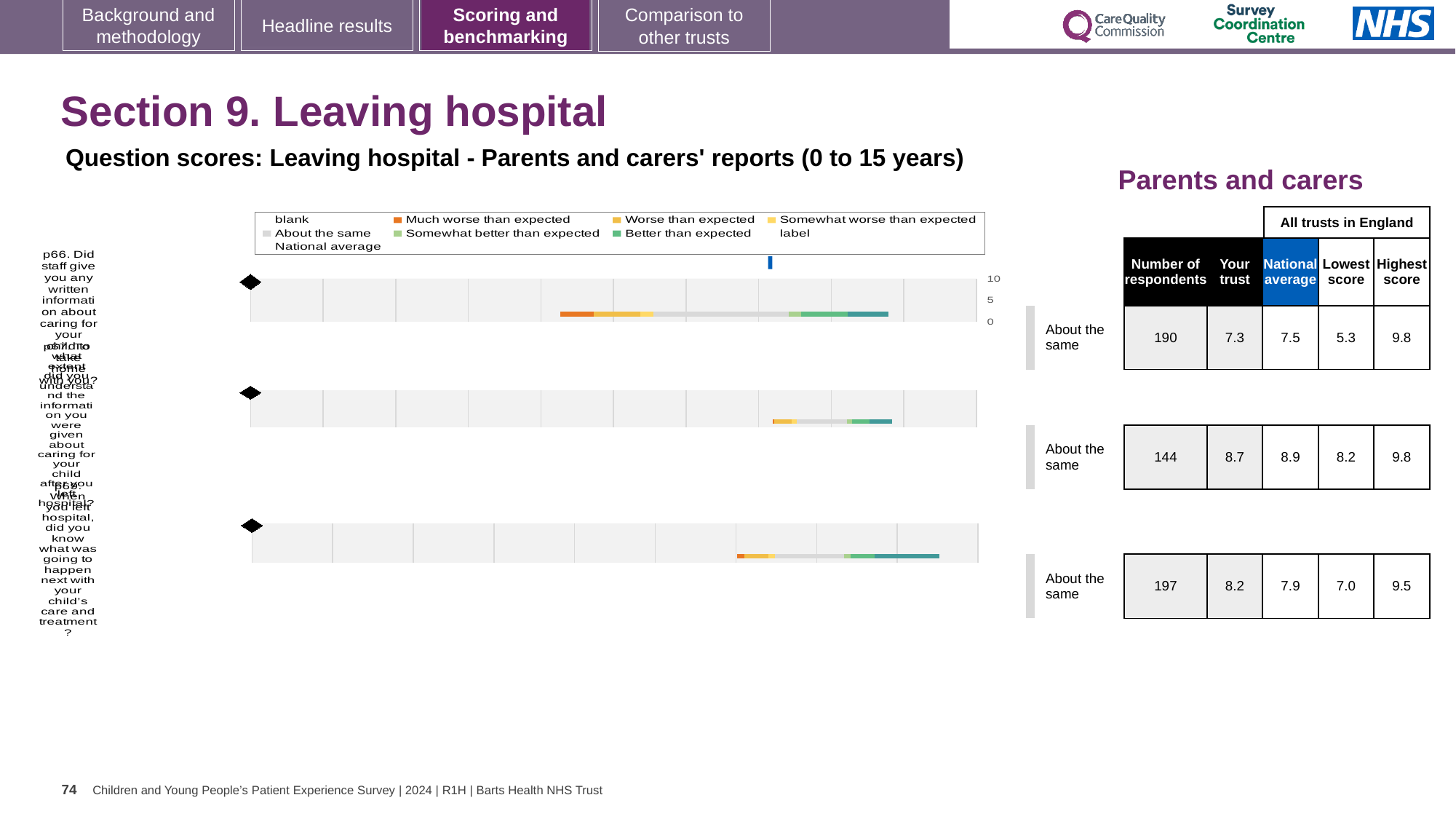
In the table beside the charts, what is the number of respondents for the third row (p68)? 197 How many separate question-score bar charts are shown on the slide? 3 In the legend, what colour represents 'Much worse than expected'? orange For the third row (p68), what is the difference between the 'Your trust' score and the national average? 0.3 In the table beside the charts, what is the national average for the third row (p68)? 7.9 In the table beside the charts, what is the 'Your trust' score for the third row (p68, what was going to happen next with your child's care and treatment)? 8.2 For the third row (p68), which is larger: the 'Your trust' score or the national average? Your trust Which row in the table has the lowest number of respondents? the second row (144) Which row in the table has the highest 'Your trust' score? the second row (8.7) What is the highest tick value shown on the axis of the bar charts? 10 What kind of chart is used to show the question scores on this slide? bar chart How many entries does the legend above the bar charts list? 9